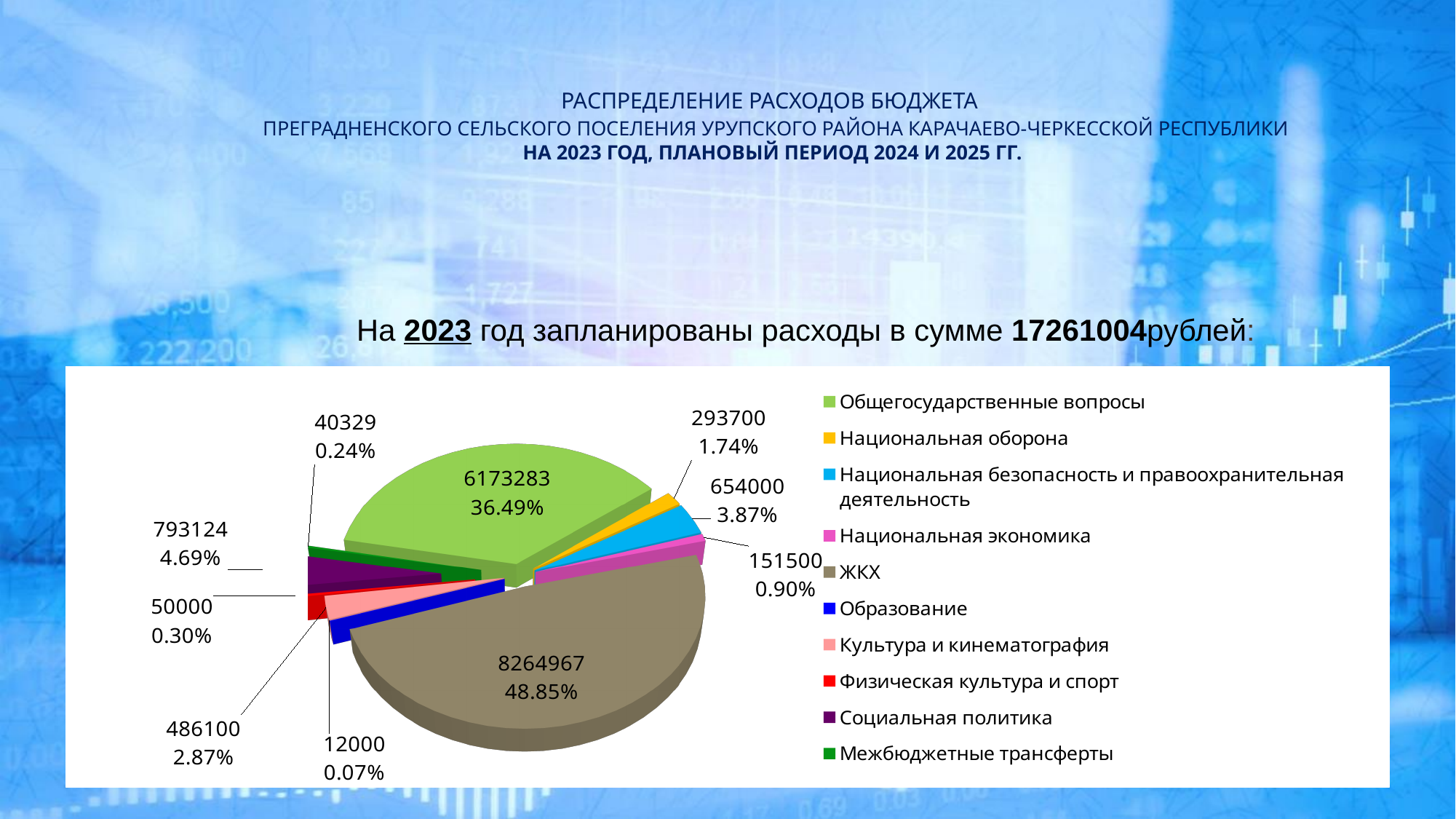
What is the value for Социальная политика? 793124 What is the difference between the values for ЖКХ and Общегосударственные вопросы? 2091684 What share of the pie does Межбюджетные трансферты take? 0.24% What is the value for Национальная безопасность и правоохранительная деятельность? 654000 Which category has the largest slice of the pie? ЖКХ What is the value for Общегосударственные вопросы? 6173283 What is the value for ЖКХ? 8264967 What share of the pie does Общегосударственные вопросы take? 36.49% What share of the pie does ЖКХ take? 48.85% What kind of chart is shown on the slide? Pie chart Which is larger, the value for Национальная оборона or the value for Национальная безопасность и правоохранительная деятельность? Национальная безопасность и правоохранительная деятельность How many categories does the legend of the pie chart list? 10